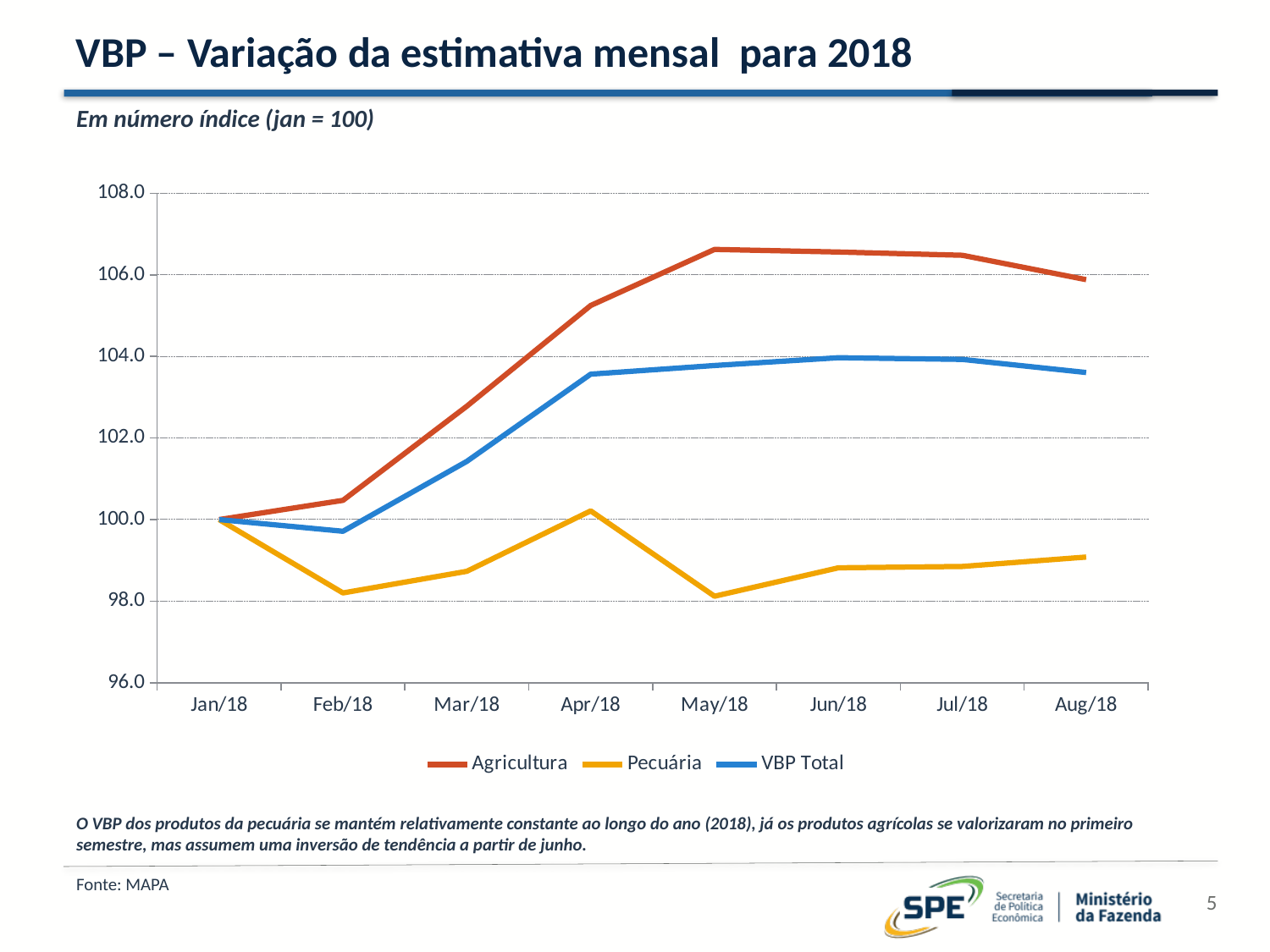
Which series has the highest value in May/18? Agricultura Is the value for VBP Total in Apr/18 greater or less than 102.0? greater Is the value for Agricultura in Apr/18 greater or less than 104.0? greater What are the three series named in the legend? Agricultura, Pecuária, VBP Total Does the Agricultura line rise or fall from Jan/18 to May/18? rise Is the value for Pecuária in Feb/18 greater or less than 100.0? less What is the value of VBP Total in Jan/18? 100.0 Which series has the lowest value in Aug/18? Pecuária What kind of chart is shown on the slide? line chart How many series does the legend list? 3 How many months are plotted along the x axis? 8